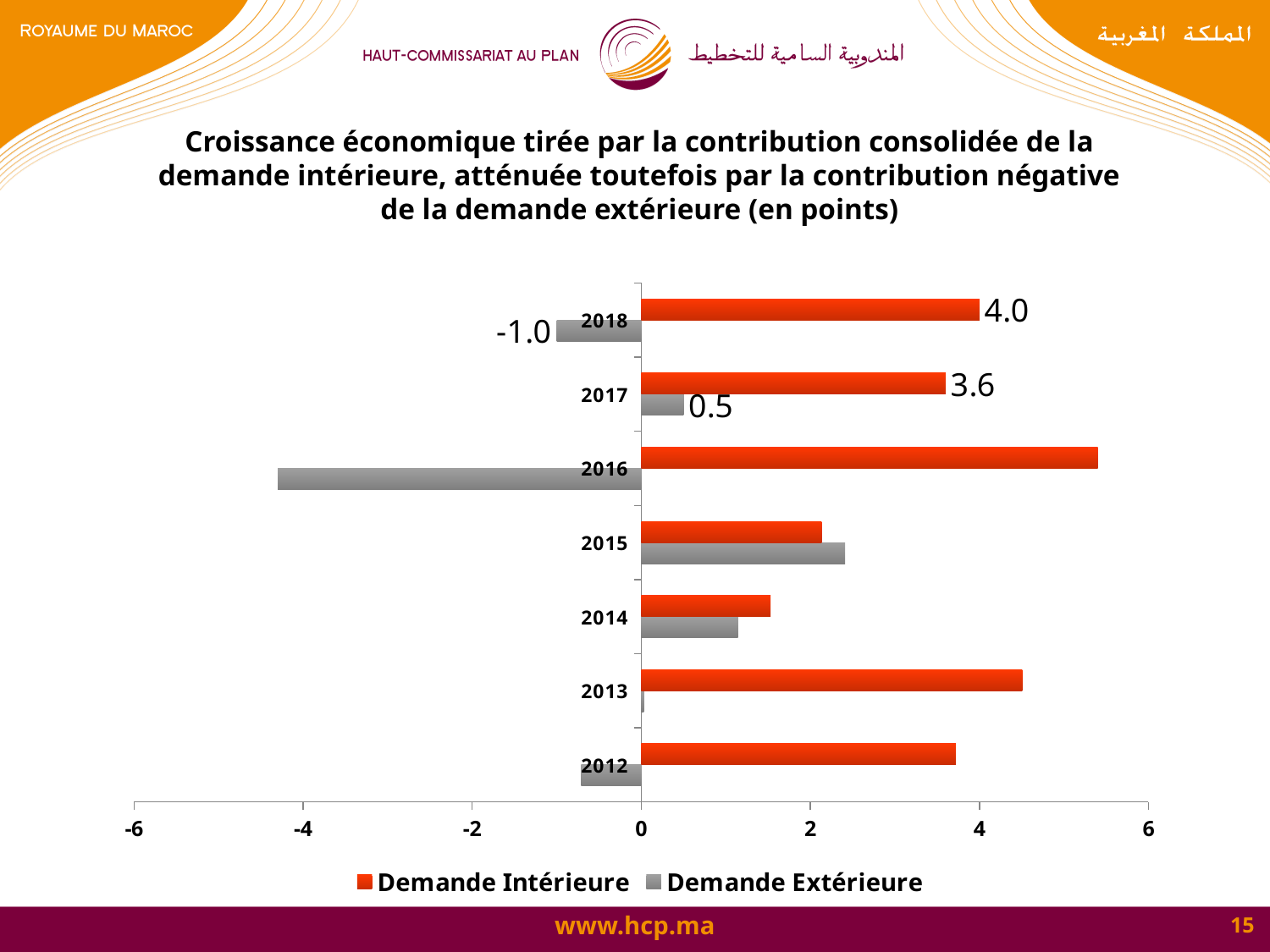
What is the value of Demande Intérieure for 2018? 4.0 What is the value of Demande Extérieure for 2018? -1.0 By how much did Demande Intérieure change from 2017 to 2018? 0.4 What is the value of Demande Extérieure for 2017? 0.5 How many series does the legend list? 2 What is the value of Demande Intérieure for 2017? 3.6 Which year has the highest value for Demande Intérieure? 2016 Is the value of Demande Extérieure for 2016 greater or less than -2? less Is the value of Demande Intérieure for 2016 greater or less than 4? greater Which is larger, Demande Intérieure in 2013 or Demande Intérieure in 2012? 2013 Which year has the lowest value for Demande Extérieure? 2016 How many years are shown on the chart? 7